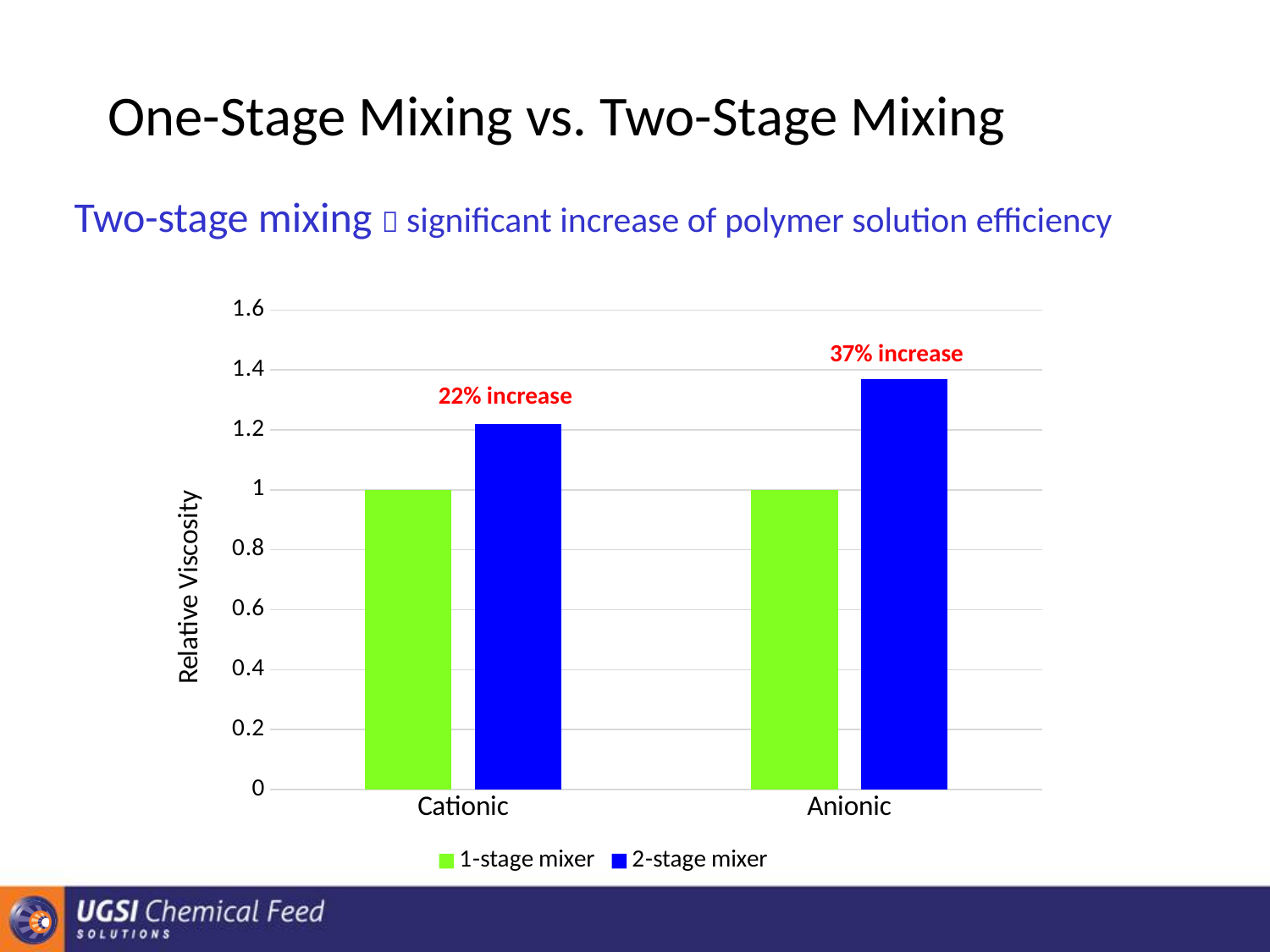
What type of chart is shown on the slide? bar chart What is the relative viscosity for the 1-stage mixer in the Cationic category? 1 What is the relative viscosity for the 1-stage mixer in the Anionic category? 1 Is the value for the 2-stage mixer in the Anionic category greater or less than 1.2? greater What is the label of the y axis? Relative Viscosity How many categories are shown on the x axis of the chart? 2 Which is larger in the Cationic category, the 1-stage mixer bar or the 2-stage mixer bar? 2-stage mixer Which category has the highest 2-stage mixer bar? Anionic How many series does the chart legend list? 2 What percentage increase is annotated above the Anionic bars? 37% increase Is the value for the 2-stage mixer in the Cationic category greater or less than 1.4? less